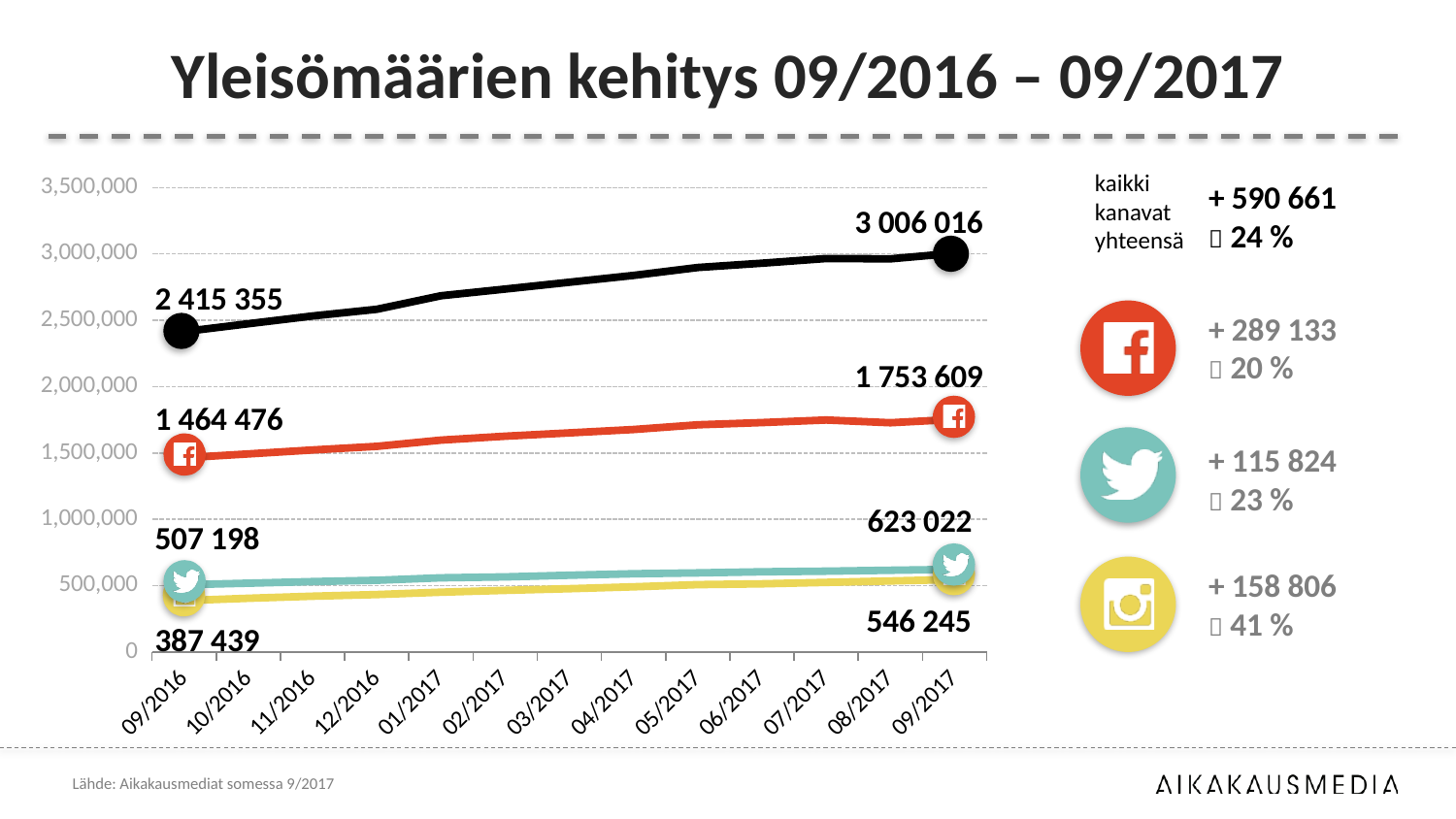
How many months are shown on the x axis? 13 By how much did the Twitter line increase from 09/2016 to 09/2017? 115 824 Is the value of the Facebook (red) line at 03/2017 greater or less than 1,500,000? greater What is the title of the slide? Yleisömäärien kehitys 09/2016 – 09/2017 At 09/2017, which is larger: the Twitter value or the Instagram value? Twitter Does the black (total) line rise or fall from 09/2016 to 09/2017? rise What is the value of the black (total) line at 09/2017? 3 006 016 What is the value of the Instagram (yellow) line at 09/2016? 387 439 What is the value of the Facebook (red) line at 09/2016? 1 464 476 By how much did the Facebook line increase from 09/2016 to 09/2017? 289 133 What is the value of the Twitter (teal) line at 09/2017? 623 022 What kind of chart is shown on the slide? line chart